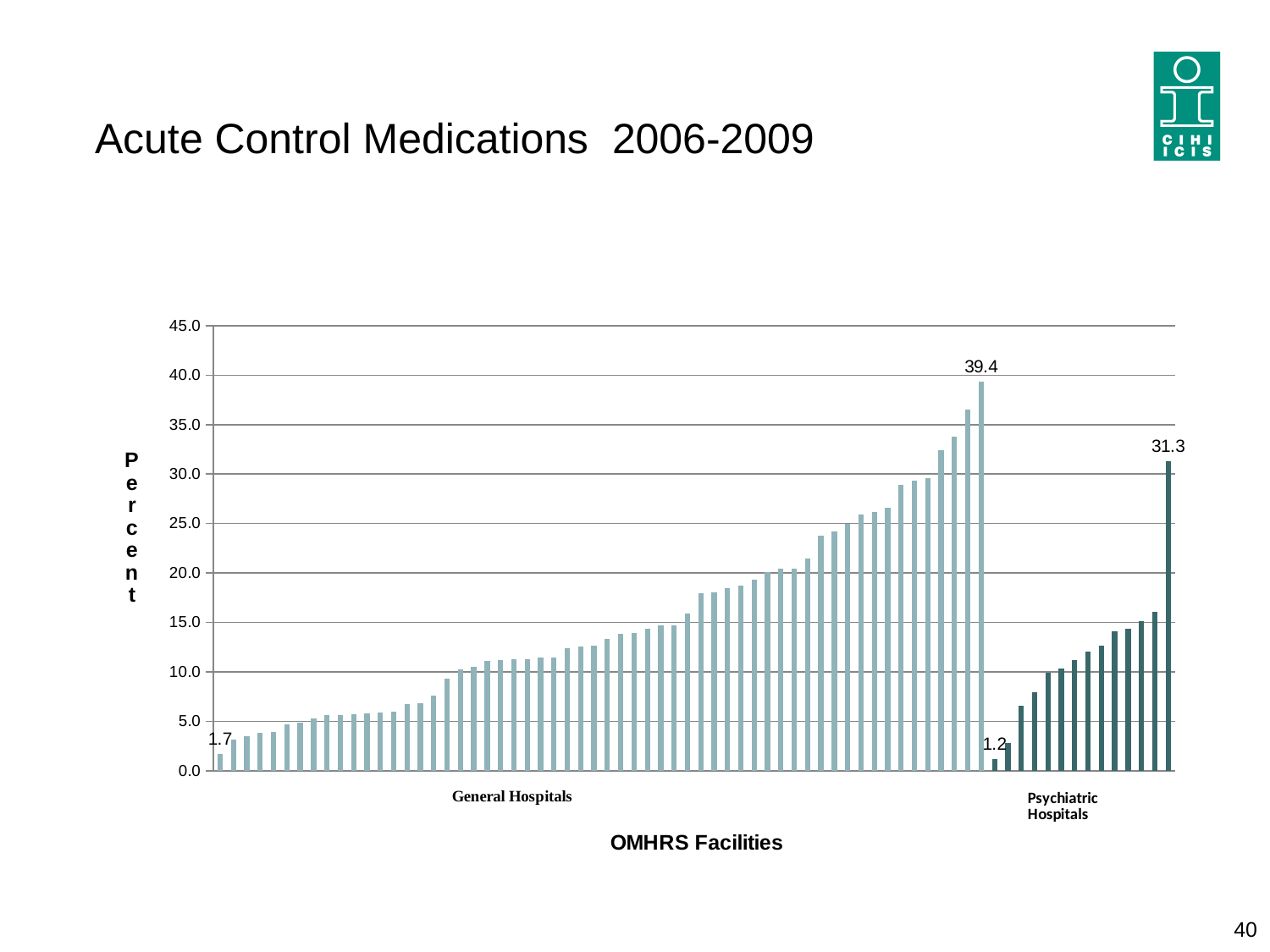
Within each facility group, do the bar values rise or fall from left to right? Rise How many facility groups are shown along the x axis? 2 What is the difference between the highest General Hospitals value (39.4) and the highest Psychiatric Hospitals value (31.3)? 8.1 Is the highest Psychiatric Hospitals value greater or less than 30.0? greater What is the lowest value shown for Psychiatric Hospitals? 1.2 What is the lowest value shown for General Hospitals? 1.7 What kind of chart is shown on the slide? Bar chart What is the highest value shown for Psychiatric Hospitals? 31.3 Which group has the higher maximum value, General Hospitals or Psychiatric Hospitals? General Hospitals What is the difference between the lowest General Hospitals value (1.7) and the lowest Psychiatric Hospitals value (1.2)? 0.5 What is the highest value shown for General Hospitals? 39.4 What is the label of the vertical axis? Percent